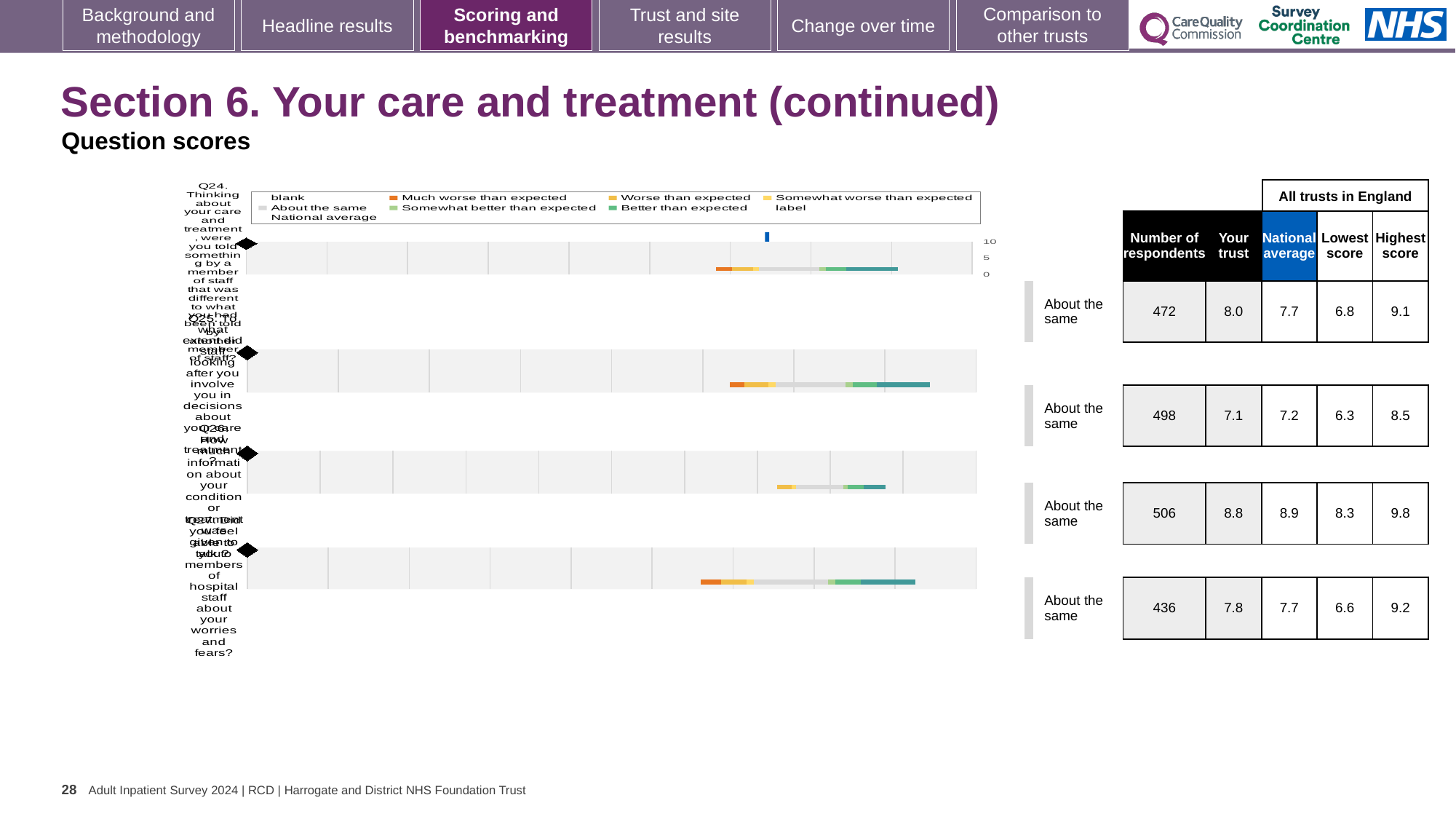
For the third chart (Q26), what is the highest score among all trusts in England? 9.8 For the first chart (Q24), what is the difference between the 'Your trust' score and the national average? 0.3 Is the 'Your trust' score for the first chart (Q24) greater or less than 5? greater How many entries does the chart legend list? 9 What benchmark category is shown next to each of the four question charts? About the same For the second chart (Q25), what is the 'Your trust' score? 7.1 For the second chart (Q25), which is larger: the 'Your trust' score or the national average? National average For the first chart (Q24), what is the number of respondents shown? 472 Which question chart has the highest 'Your trust' score? Q26 Which question chart has the lowest number of respondents? Q27 How many separate question charts are shown on the slide? 4 What kind of chart is used on this slide to show the question scores? bar chart